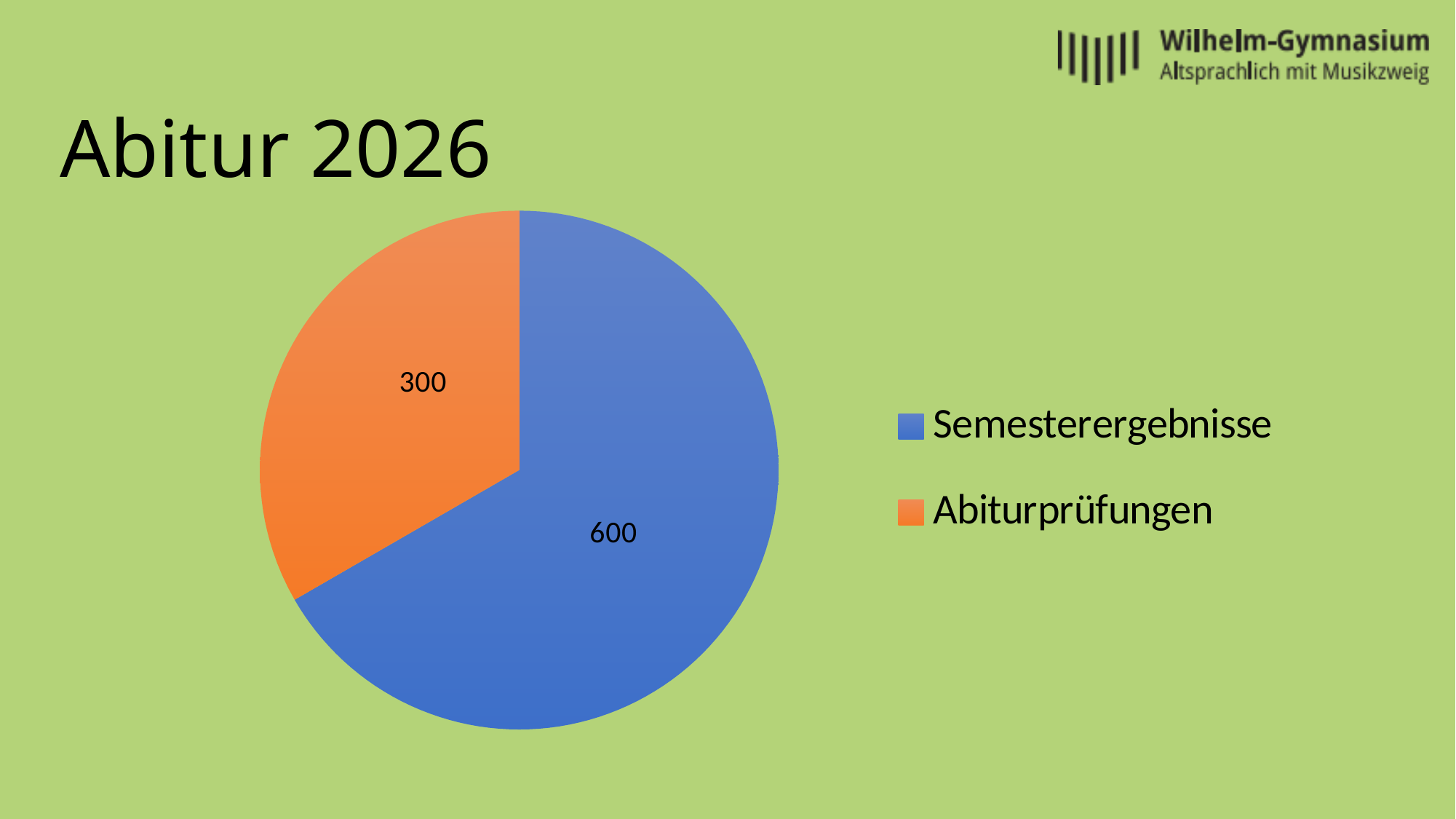
What value is shown for Abiturprüfungen? 300 How many slices does the pie chart have? 2 Which slice of the pie chart is the smallest? Abiturprüfungen What colour is the Abiturprüfungen slice? Orange Which slice of the pie chart is the largest? Semesterergebnisse What kind of chart is shown on the slide? Pie chart What share of the pie does Semesterergebnisse represent? Two thirds What value is shown for Semesterergebnisse? 600 What share of the pie does Abiturprüfungen represent? One third What is the difference between the values for Semesterergebnisse and Abiturprüfungen? 300 Which is larger, Semesterergebnisse or Abiturprüfungen? Semesterergebnisse What is the total of the two values in the pie chart? 900